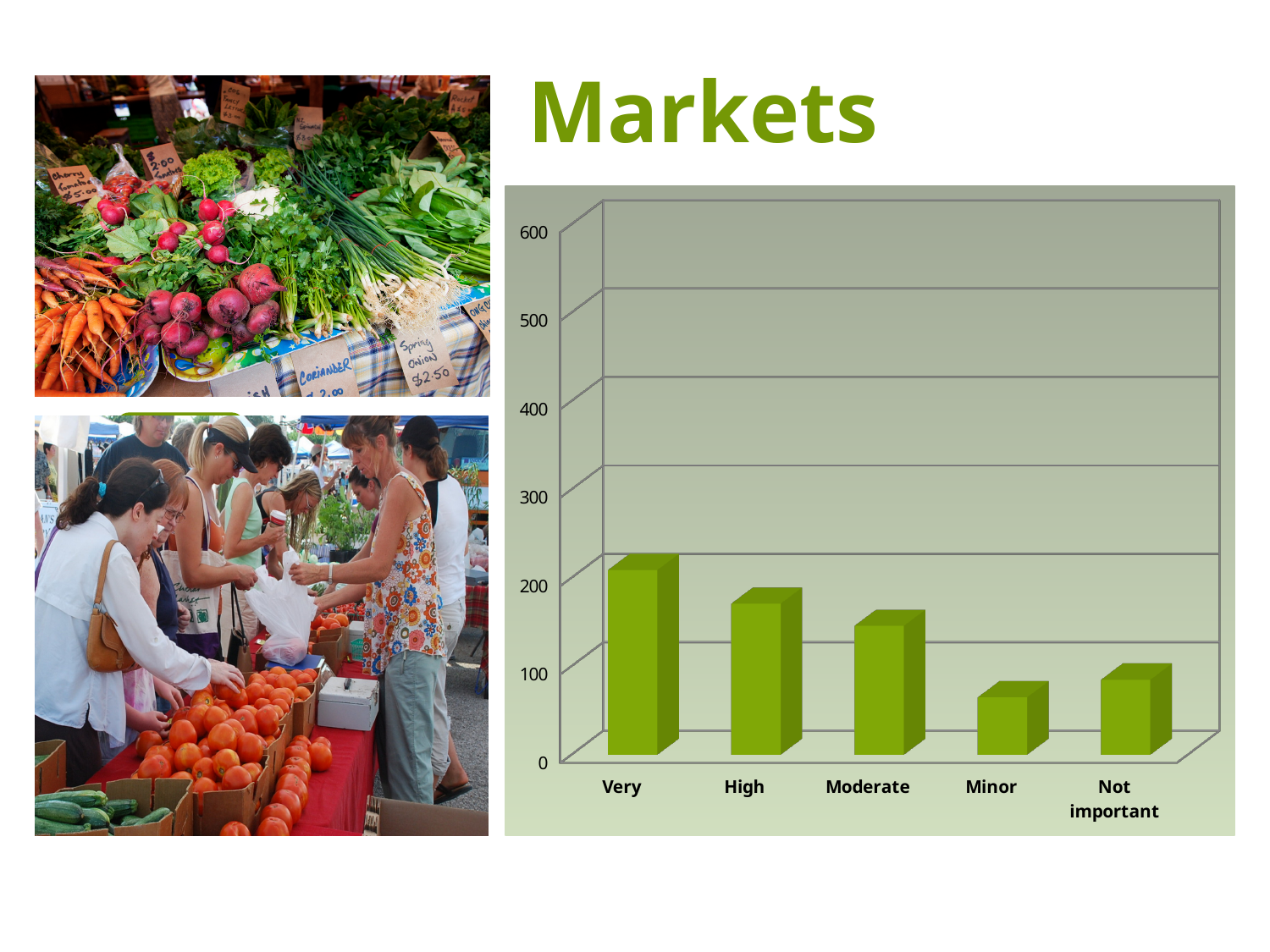
Is the value for Minor greater or less than 100? less Do the values rise or fall from Very to Minor along the x axis? fall Is the value for Moderate greater or less than 200? less What is the title of the slide containing the chart? Markets What kind of chart is shown on the slide? bar chart How many categories are shown on the x axis of the chart? 5 Is the value for Very greater or less than 100? greater Which category has the lowest bar in the chart? Minor Which is larger, the value for High or the value for Moderate? High Which category has the highest bar in the chart? Very Which is larger, the value for Minor or the value for Not important? Not important